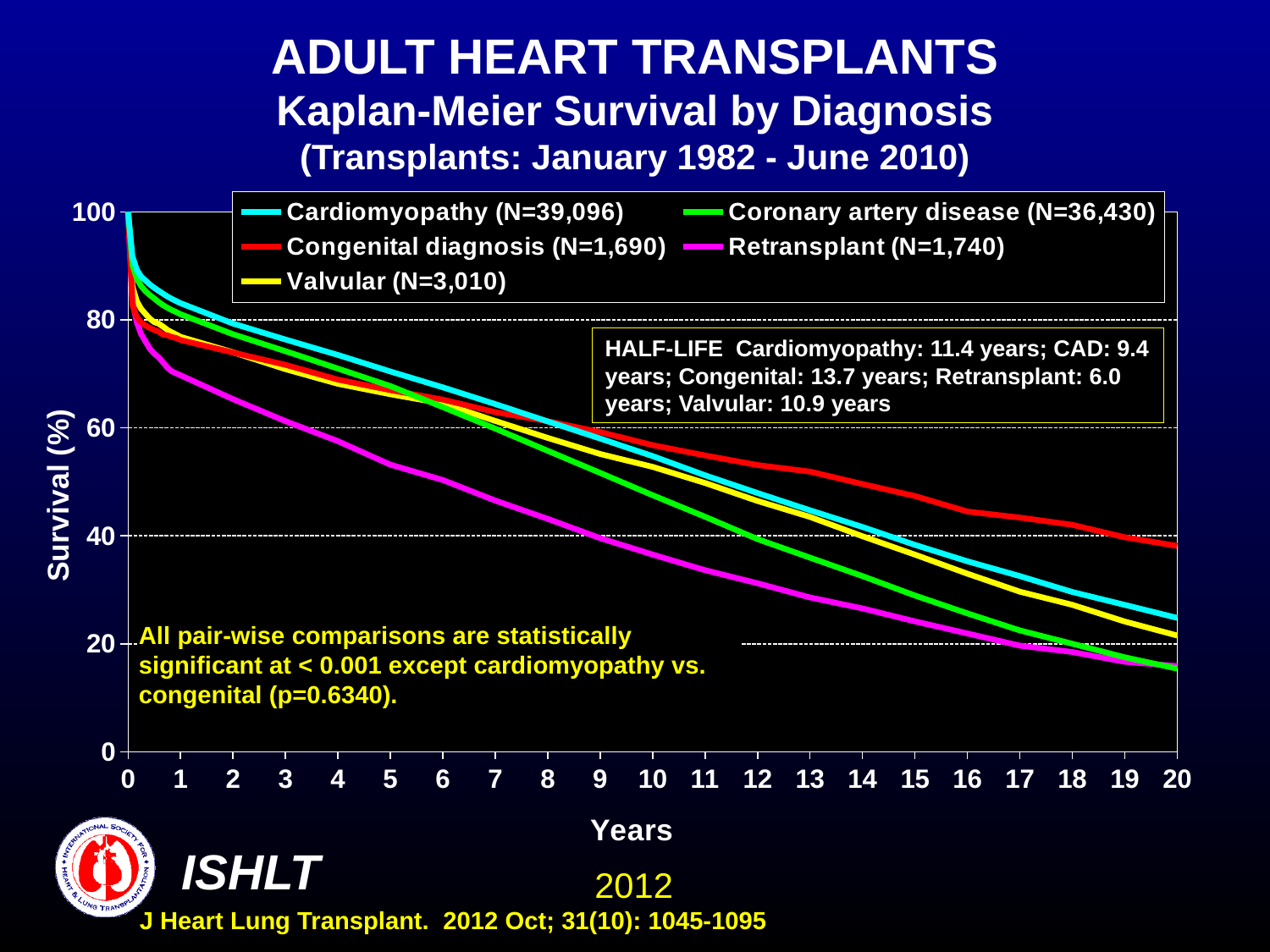
What is the difference between the half-life of the Congenital group and the Retransplant group? 7.7 years What is the p-value given for the cardiomyopathy vs. congenital comparison? 0.6340 What is the half-life for the Congenital diagnosis group? 13.7 years What is the number of patients (N) in the Cardiomyopathy group? 39,096 What kind of chart is shown on the slide? Line chart Is the survival for the Retransplant group at 12 years greater or less than 40%? less Which diagnosis group has the highest survival at 20 years? Congenital diagnosis Which diagnosis group has the shortest half-life? Retransplant (6.0 years) Which diagnosis group has the lowest survival at 5 years? Retransplant Do the survival curves rise or fall as years since transplant increase? Fall How many diagnosis groups (series) does the legend list? 5 At 15 years, which group has higher survival: Cardiomyopathy or Retransplant? Cardiomyopathy